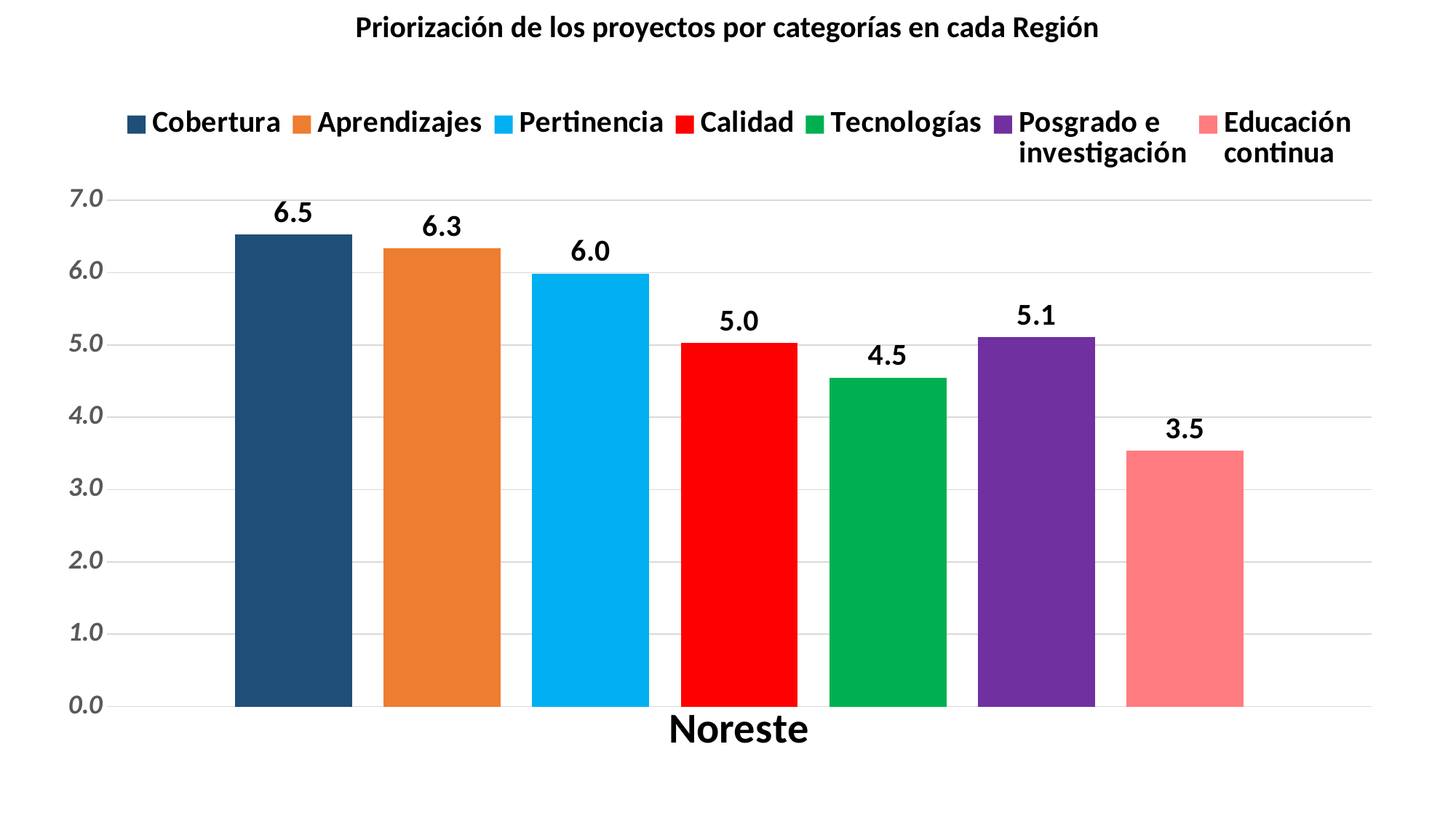
Which is larger, the value for Pertinencia or the value for Calidad? Pertinencia Which series has the lowest value? Educación continua What is the value for Cobertura in the Noreste region? 6.5 Is the value for Tecnologías greater or less than 5.0? less Which series has the highest value? Cobertura What is the title of the chart? Priorización de los proyectos por categorías en cada Región What is the difference between the values for Aprendizajes and Tecnologías? 1.8 What is the value for Educación continua? 3.5 What is the difference between the values for Cobertura and Educación continua? 3.0 What is the value for Posgrado e investigación? 5.1 What kind of chart is shown on the slide? bar chart How many series does the legend list? 7